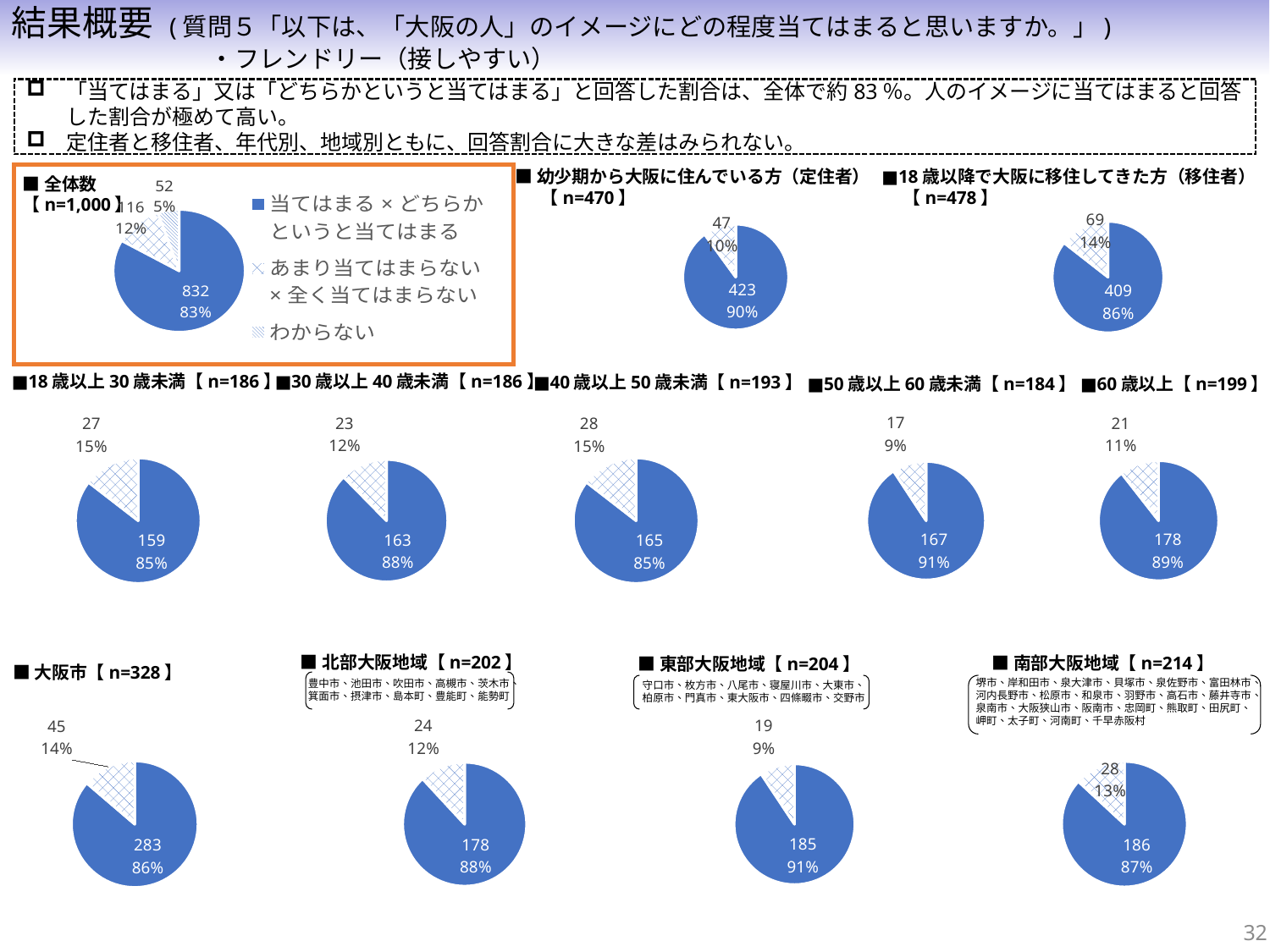
In the 全体数【n=1,000】 chart, what percentage share does the わからない slice have? 5% In the 大阪市【n=328】 chart, what percentage share does the largest slice have? 86% In the 50歳以上60歳未満【n=184】 chart, what is the value of the smaller slice? 17 In the 18歳以降で大阪に移住してきた方（移住者）【n=478】 chart, what percentage share does the smaller slice have? 14% What is the difference between the larger slice values in the 60歳以上【n=199】 chart and the 18歳以上30歳未満【n=186】 chart? 19 In the 全体数【n=1,000】 chart, what is the value for 当てはまる × どちらかというと当てはまる? 832 Which is larger: the largest slice in the 東部大阪地域【n=204】 chart or the largest slice in the 北部大阪地域【n=202】 chart? 東部大阪地域 (185) How many slices does the 30歳以上40歳未満【n=186】 pie chart show? 2 What kind of chart is used for the 全体数【n=1,000】 data? Pie chart In the 南部大阪地域【n=214】 chart, what is the value of the smaller slice? 28 How many entries does the legend of the 全体数【n=1,000】 chart list? 3 In the 幼少期から大阪に住んでいる方（定住者）【n=470】 chart, what is the value of the largest slice? 423